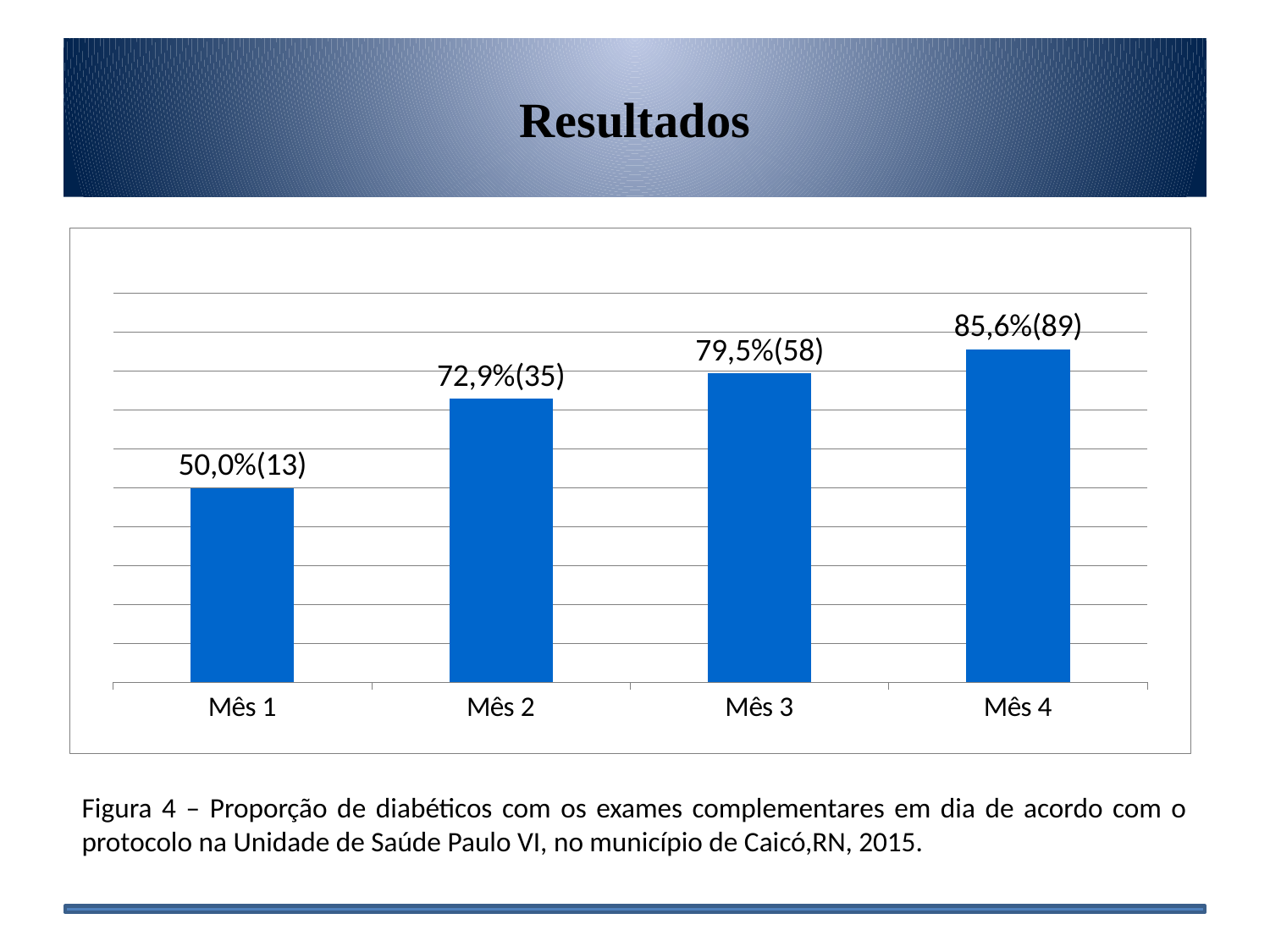
How many months are shown on the x axis? 4 What is the data label shown for Mês 1? 50,0%(13) What percentage is shown for Mês 3? 79,5% What is the difference between the numbers in parentheses for Mês 4 and Mês 1? 76 What kind of chart is shown on the slide? Bar chart What percentage is shown for Mês 2? 72,9% What is the number in parentheses shown for Mês 3? 58 What is the difference in percentage points between Mês 4 and Mês 1? 35,6 What is the data label shown for Mês 4? 85,6%(89) Which month has the highest value? Mês 4 Which month has the lowest value? Mês 1 Which has a larger value, Mês 2 or Mês 3? Mês 3